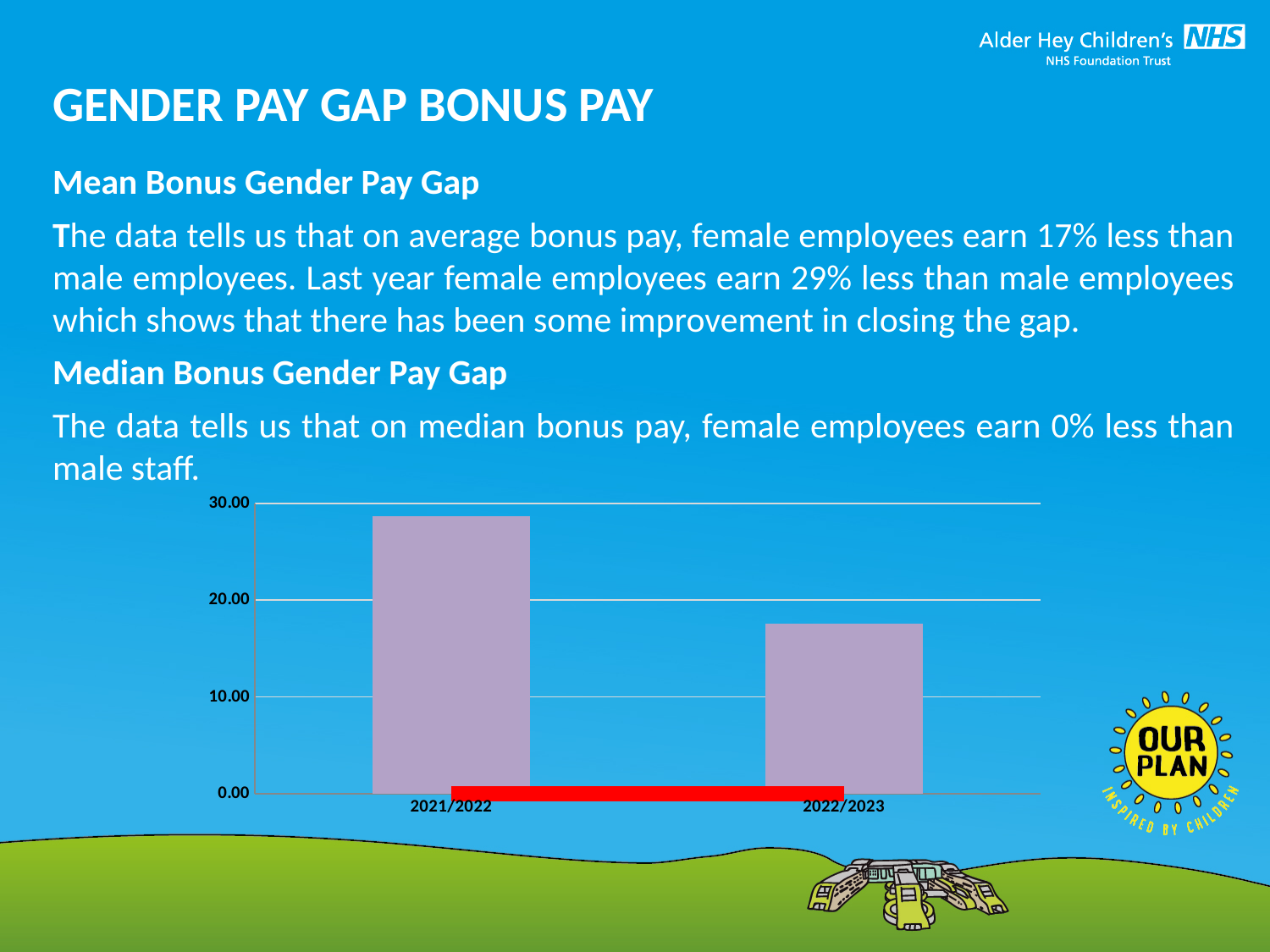
Do the bar values rise or fall from 2021/2022 to 2022/2023? fall Is the value for 2021/2022 greater or less than 20.00? greater What kind of chart is shown on the slide? bar chart Is the value for 2022/2023 greater or less than 20.00? less What are the two category labels on the x axis of the chart? 2021/2022 and 2022/2023 Which category has the lowest bar in the chart? 2022/2023 Which bar is taller, 2021/2022 or 2022/2023? 2021/2022 Is the value for 2021/2022 greater or less than 30.00? less Which category has the highest bar in the chart? 2021/2022 How many categories are shown on the x axis of the chart? 2 What is the highest tick value shown on the y axis of the chart? 30.00